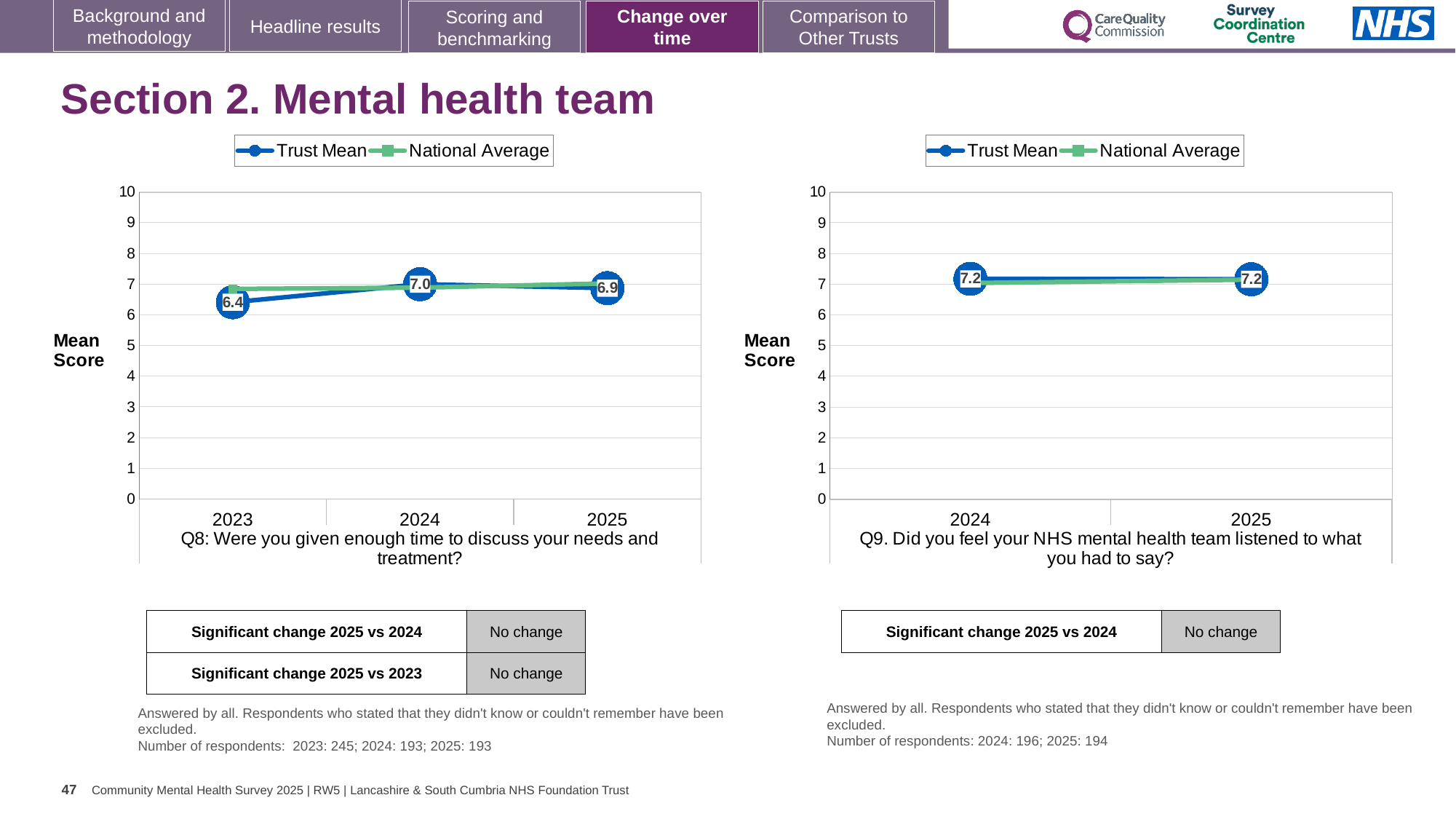
In the Q8 chart on the left, which year has the highest Trust Mean? 2024 In the Q8 chart on the left, what is the Trust Mean for 2025? 6.9 In the Q8 chart on the left, what is the difference between the Trust Mean for 2024 and 2023? 0.6 In the Q8 chart on the left, what is the Trust Mean for 2024? 7.0 What type of chart is the Q9 chart on the right? Line chart In the Q8 chart on the left, is the Trust Mean larger in 2023 or 2024? 2024 In the Q8 chart on the left, is the National Average for 2023 greater or less than 6? greater In the Q9 chart on the right, what is the Trust Mean for 2025? 7.2 How many years are shown on the x axis of the Q9 chart on the right? 2 In the Q8 chart on the left, what is the Trust Mean for 2023? 6.4 In the Q8 chart on the left, which year has the lowest Trust Mean? 2023 How many series does the legend of the Q8 chart on the left list? 2